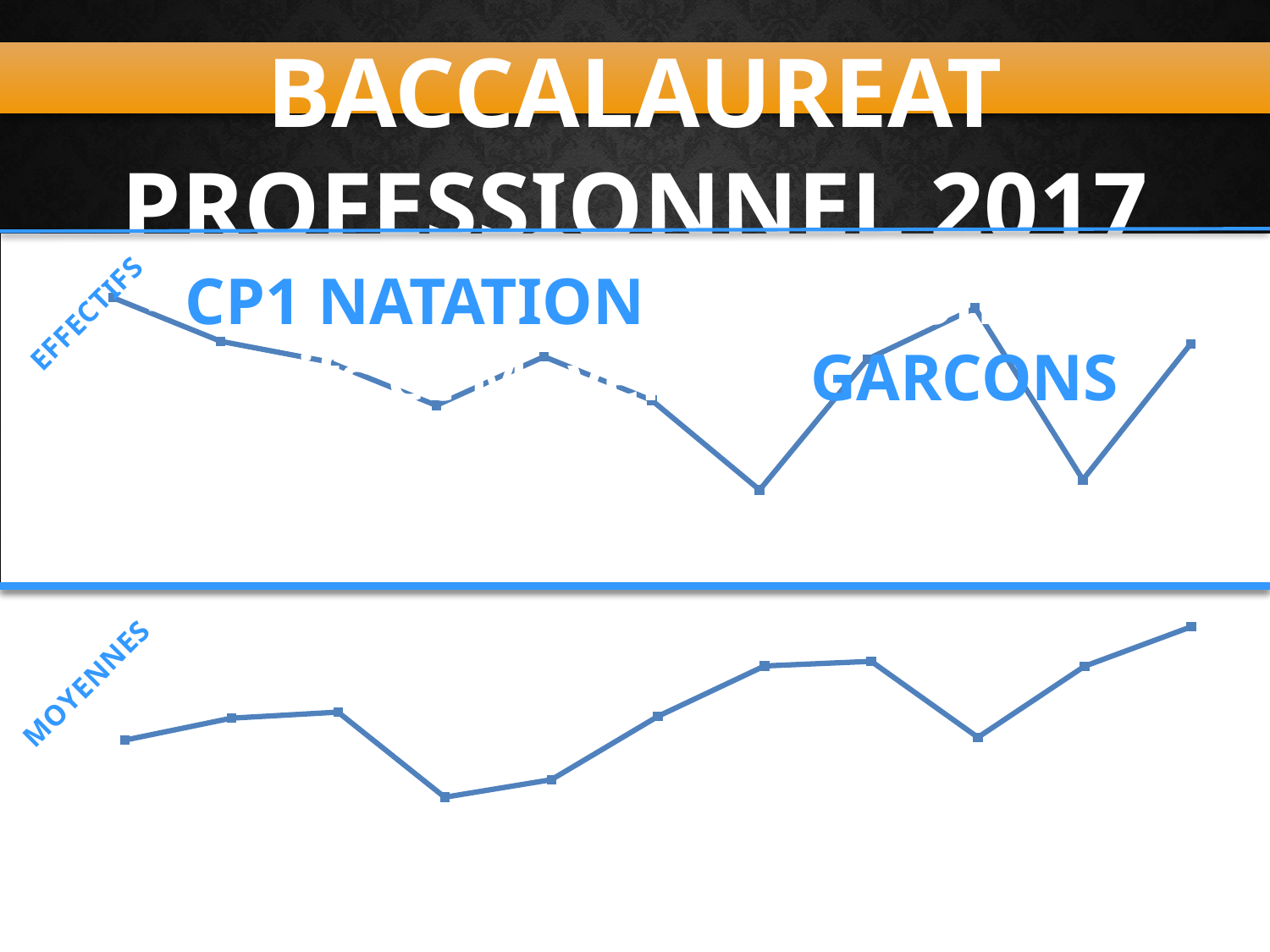
In the bottom chart, does the line rise or fall between the first and second points? rise What kind of chart is the top chart on the slide? line chart What label is written along the left side of the bottom chart? MOYENNES In the bottom chart, does the line end higher or lower than it starts? higher What label is written along the left side of the top chart? EFFECTIFS What kind of chart is the bottom chart on the slide? line chart How many data points are plotted on the top chart? 11 How many data points are plotted on the bottom chart? 11